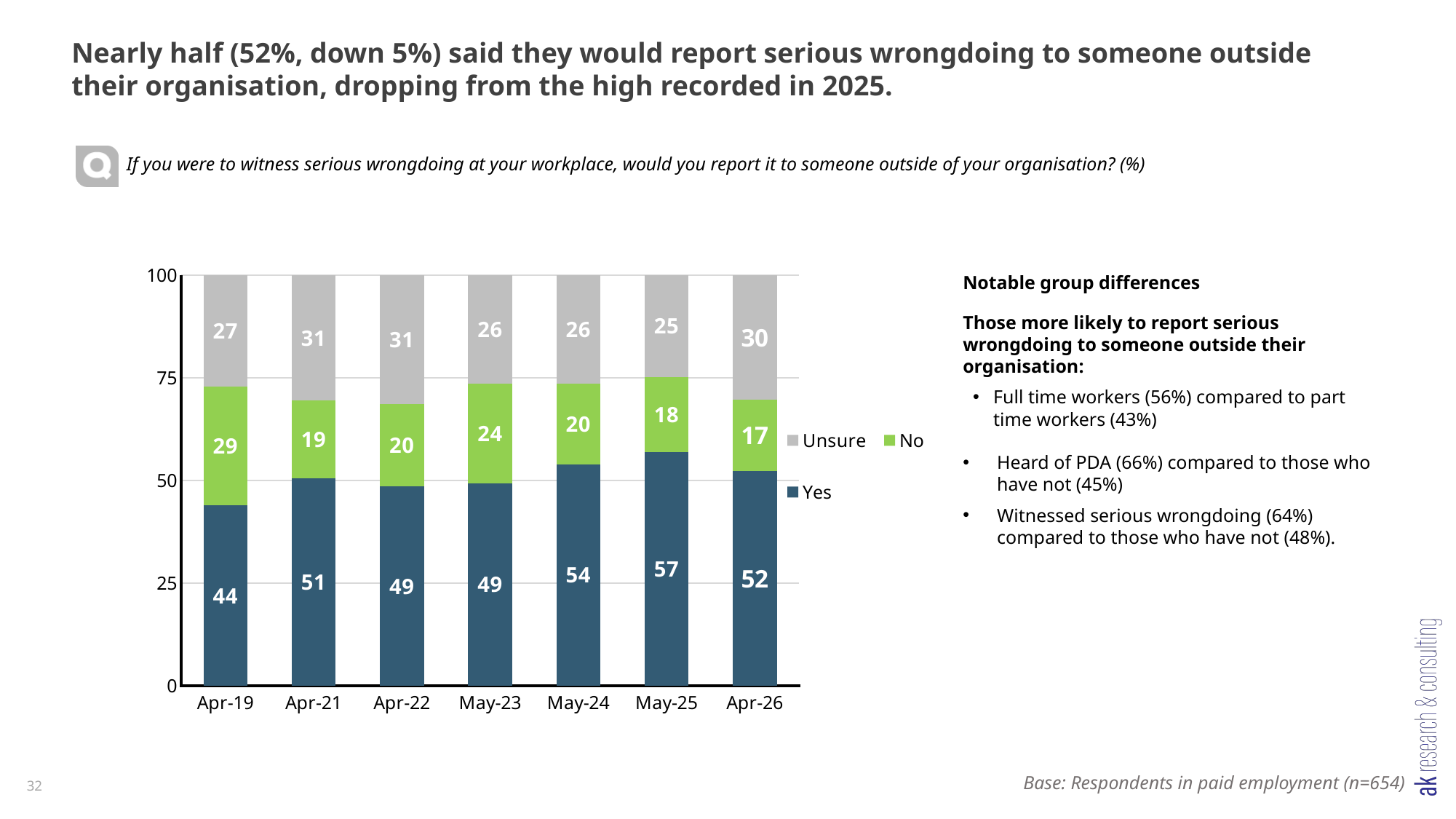
How many series does the legend list? 3 What is the total of the stacked bar for Apr-19? 100 Which is larger, the Unsure value in Apr-21 or the Unsure value in May-23? Apr-21 What kind of chart is shown? Stacked bar chart What is the value for No in Apr-19? 29 What is the value for Unsure in Apr-26? 30 What is the value for Yes in May-25? 57 Which period has the lowest value for No? Apr-26 What is the difference between the Yes value in May-25 and the Yes value in Apr-26? 5 Which period has the highest value for Yes? May-25 Which colour represents the Yes series? Dark blue How many periods are shown on the x axis? 7